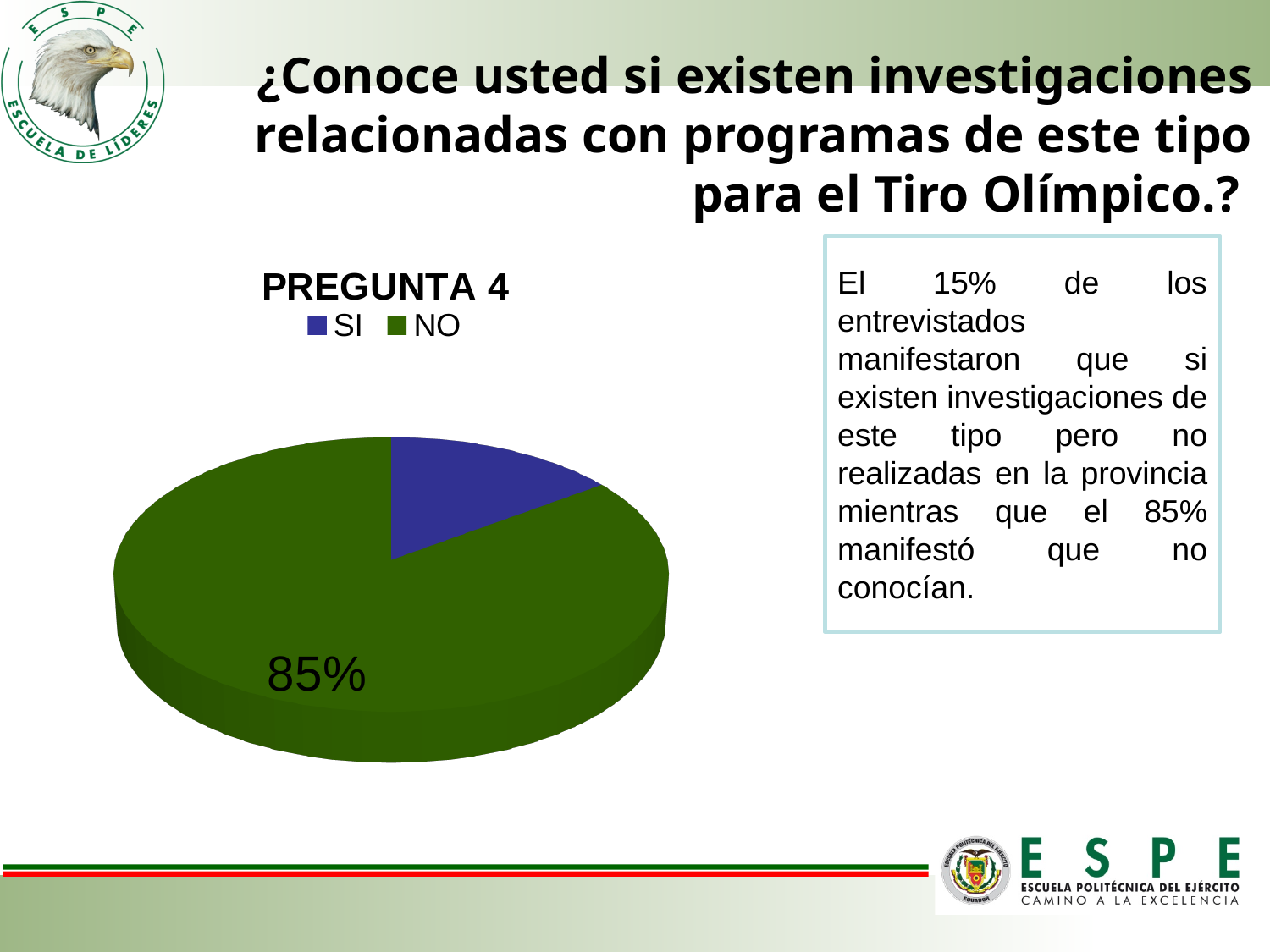
Which category has the largest slice of the pie? NO Which category has the smallest slice of the pie? SI What share of the pie does the NO slice represent? 85% How many slices does the pie chart have? 2 How many entries does the chart legend list? 2 What kind of chart is shown on the slide? pie chart What is the title of the chart? PREGUNTA 4 What colour is the NO slice in the pie chart? green Which slice is larger, SI or NO? NO